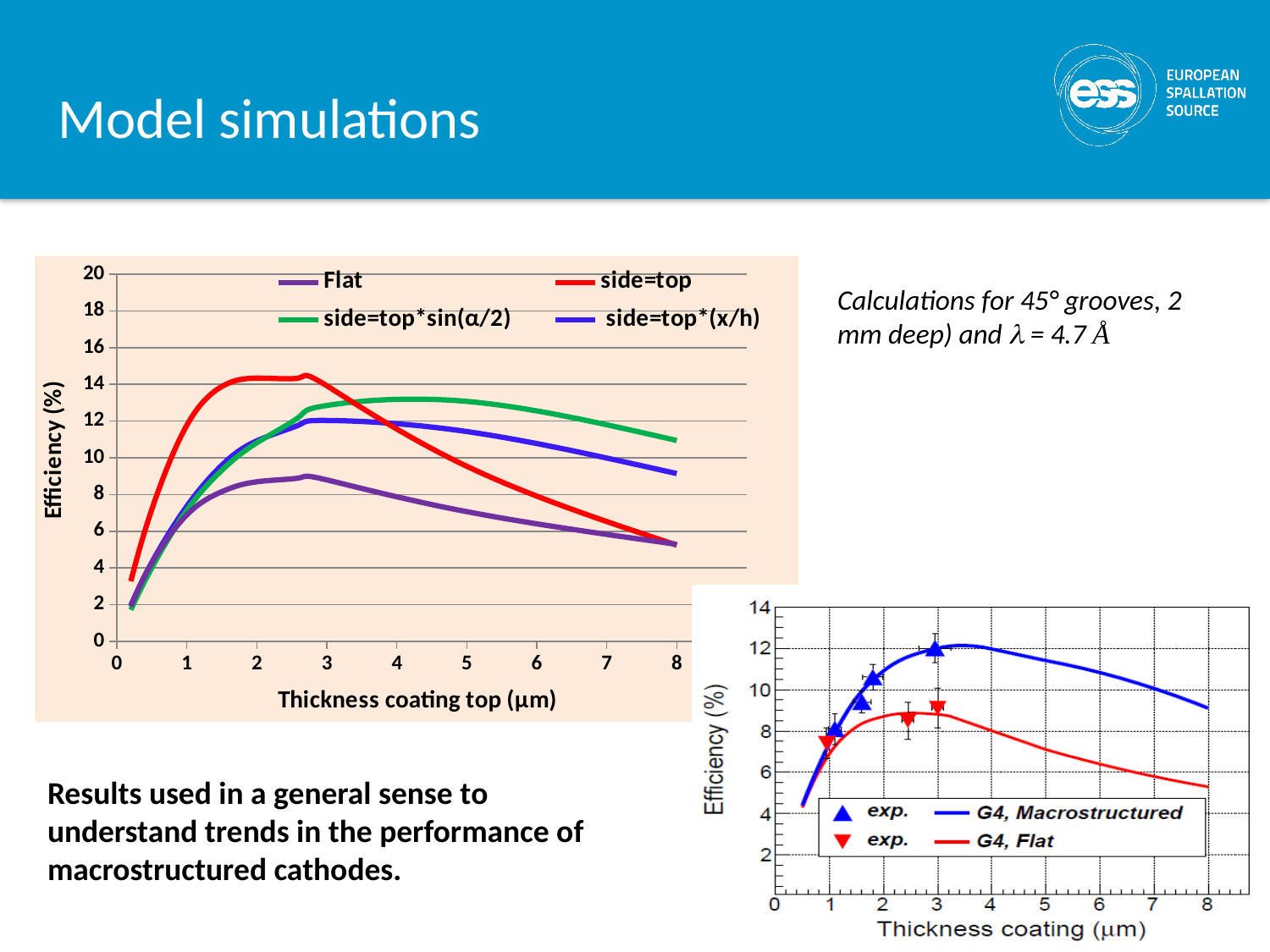
In the top-left chart, what is the x-axis title? Thickness coating top (µm) In the top-left chart, is the peak efficiency of the side=top series greater or less than 14? greater In the top-left chart, is the efficiency of the Flat series at 8 µm greater or less than 6? less In the bottom-right chart, how many entries does the legend list? 4 In the top-left chart, how many series does the legend list? 4 In the top-left chart, which series has the lowest efficiency at a thickness of 4 µm? Flat In the top-left chart, does the efficiency of the Flat series rise or fall between 3 µm and 8 µm? fall In the bottom-right chart, is the peak efficiency of the G4, Flat curve greater or less than 10? less In the top-left chart, which series reaches the highest peak efficiency? side=top What kind of chart is the top-left chart with the legend entries Flat and side=top? line chart In the bottom-right chart, which curve is higher at a thickness of 3 µm: G4, Macrostructured or G4, Flat? G4, Macrostructured In the top-left chart, at a thickness of 8 µm, which series has the higher efficiency: side=top*sin(α/2) or side=top*(x/h)? side=top*sin(α/2)